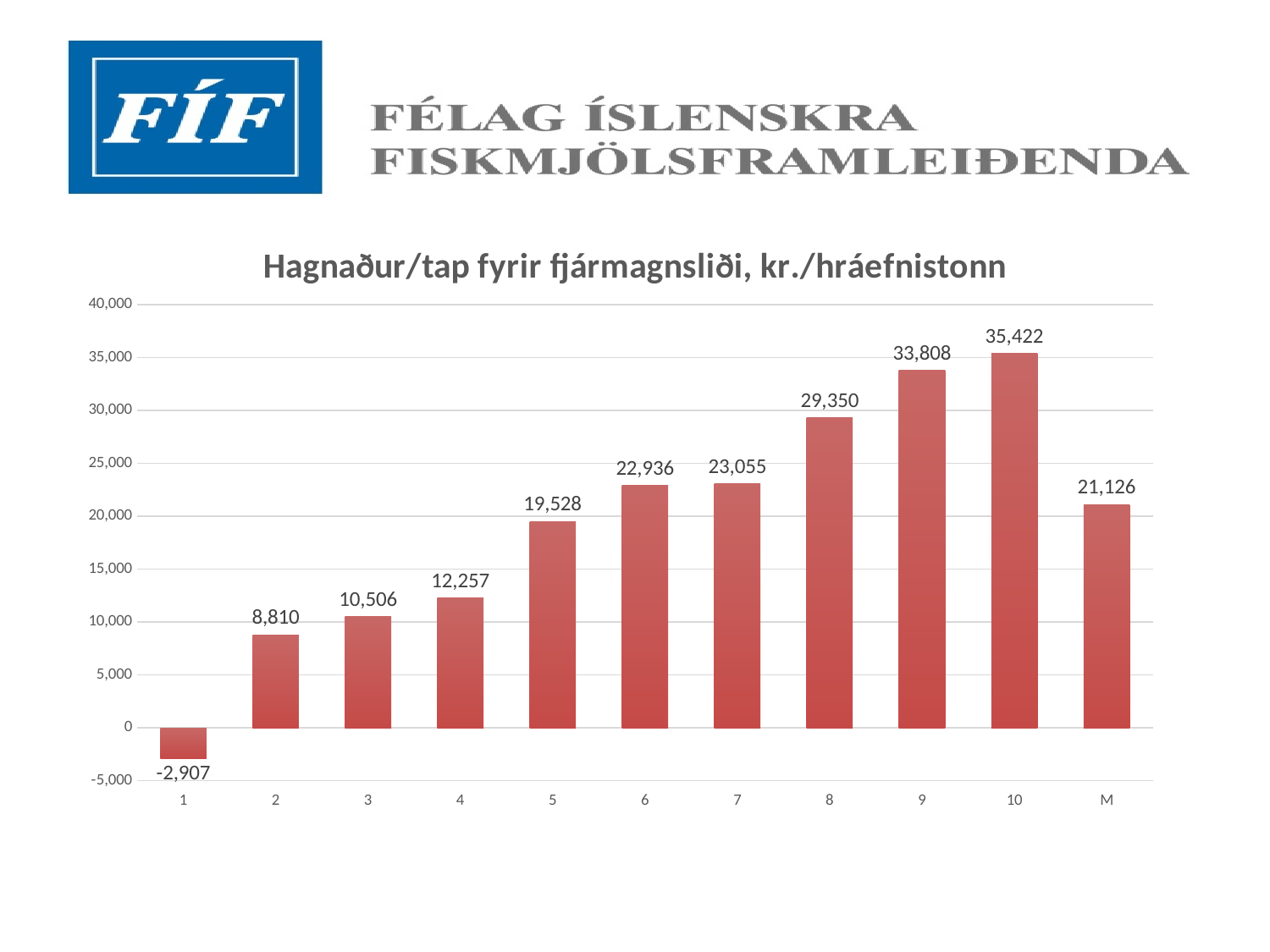
What is the value for category 1? -2,907 What is the difference between the values for category 10 and category 9? 1,614 What kind of chart is this? bar chart Which category has the highest value? 10 Is the value for category 6 greater or less than 20,000? greater How many categories are shown on the x axis? 11 Which is larger, the value for category 8 or the value for category M? 8 What is the value for category 5? 19,528 Do the values rise or fall from category 1 to category 10? rise What is the value for category M? 21,126 What is the title of the chart? Hagnaður/tap fyrir fjármagnsliði, kr./hráefnistonn Which category has the lowest value? 1